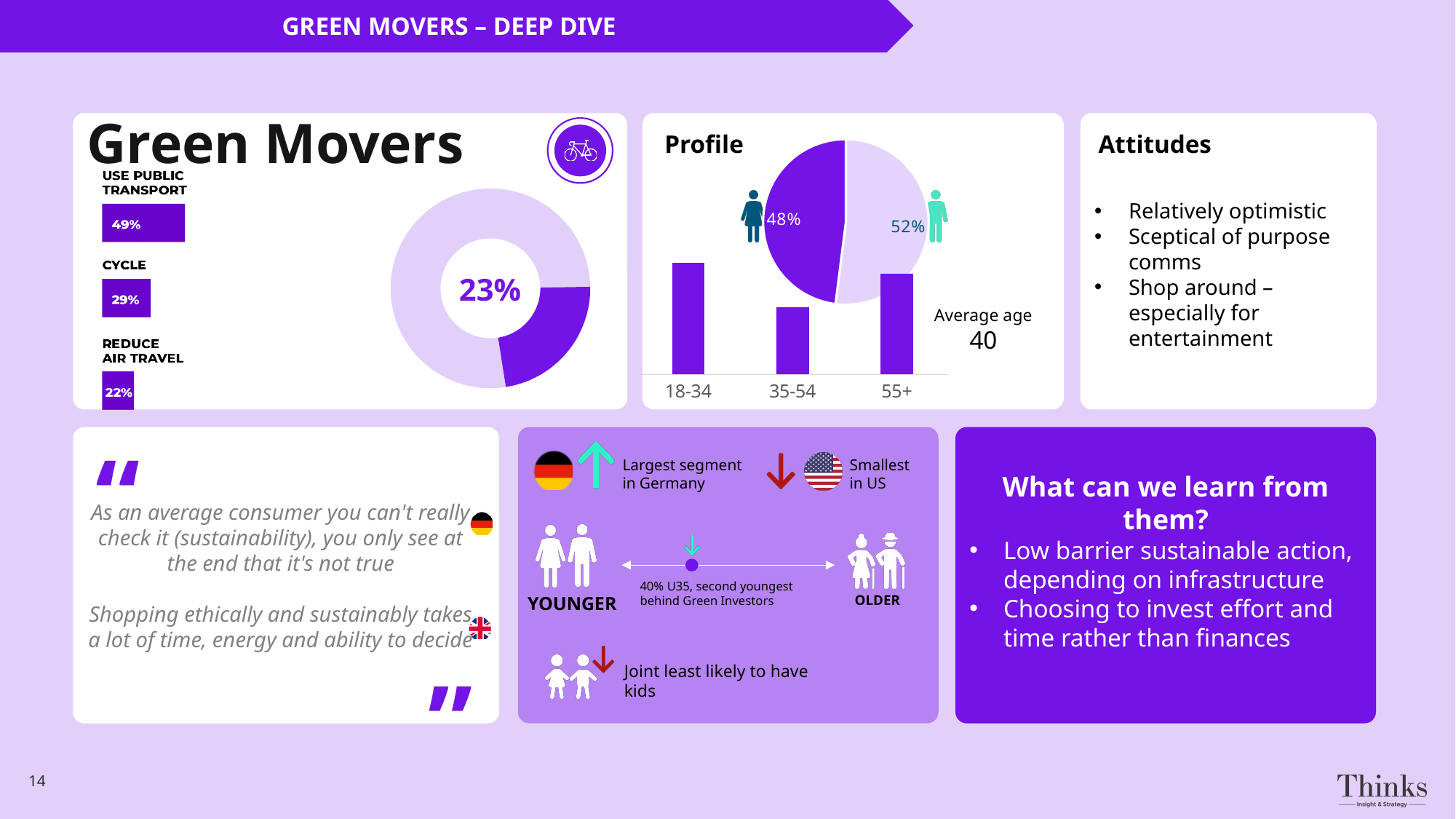
In the Profile age bar chart, which age group has the shortest bar? 35-54 In the Profile age bar chart, which age group has the tallest bar? 18-34 In the Profile pie chart, what share is shown for the dark purple (male) slice? 48% What kind of chart shows the age groups 18-34, 35-54 and 55+ in the Profile panel? bar chart In the Profile pie chart, what share is shown for the light purple (female) slice? 52% In the Profile age bar chart, how many age groups are shown? 3 In the Profile pie chart, which slice is larger, the 48% male slice or the female slice? the female slice (52%) In the Green Movers donut chart, what percentage is shown in the centre? 23% In the Green Movers panel bars, what is the difference between Use Public Transport and Reduce Air Travel? 27% In the Profile pie chart, how many slices are there? 2 In the Green Movers panel bars, what is the value for Cycle? 29% In the Profile pie chart, what is the difference between the female share and the male share? 4%